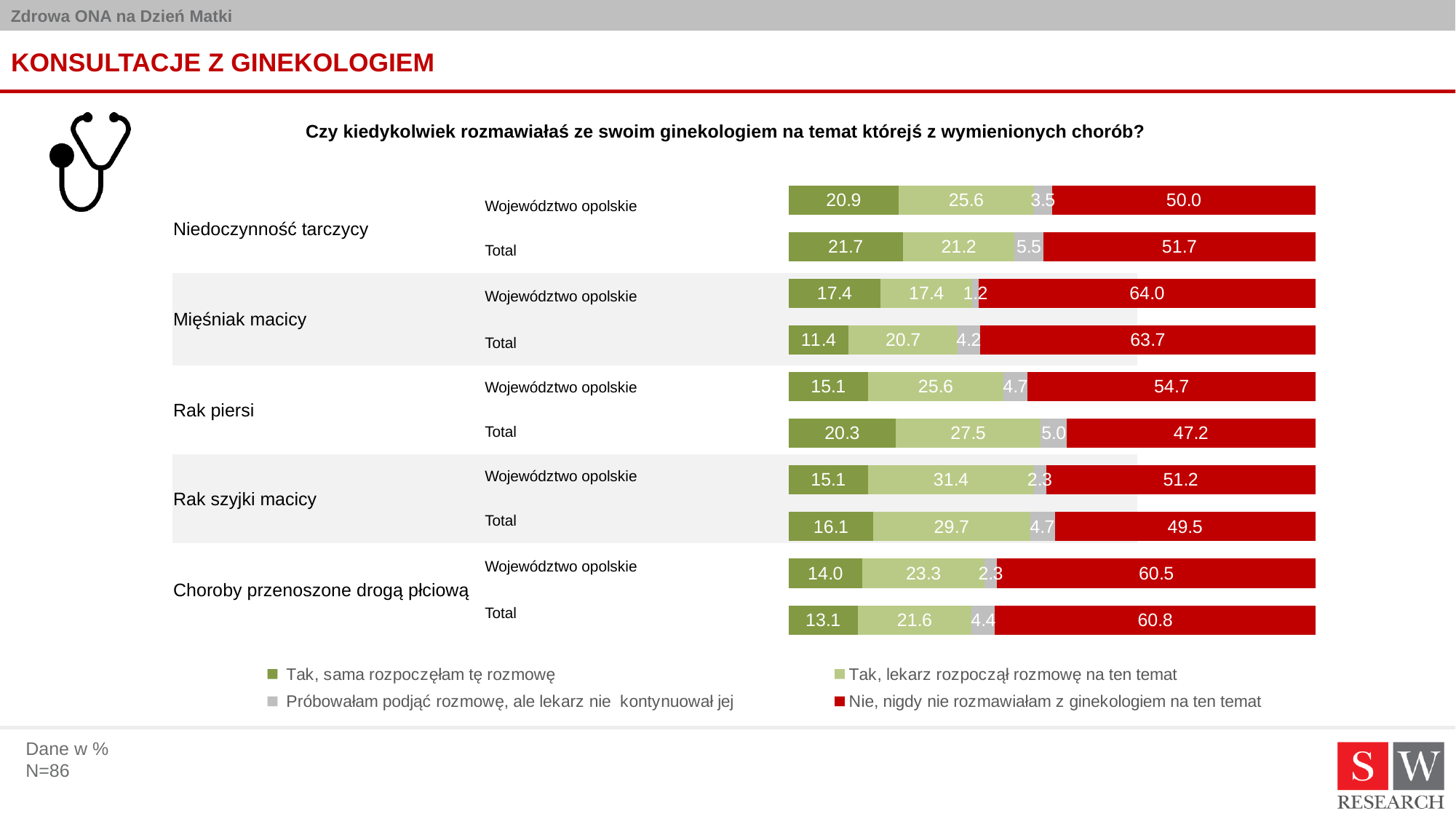
How many series does the legend list? 4 For Rak piersi, what is the difference between the Województwo opolskie and Total values for "Nie, nigdy nie rozmawiałam z ginekologiem na ten temat"? 7.5 What is the value for "Próbowałam podjąć rozmowę, ale lekarz nie kontynuował jej" for Niedoczynność tarczycy, Total? 5.5 How many bars are plotted in the chart? 10 What is the value for "Tak, sama rozpoczęłam tę rozmowę" for Rak piersi, Total? 20.3 Which colour represents "Nie, nigdy nie rozmawiałam z ginekologiem na ten temat" in the legend? Red What is the total of the stacked bar for Niedoczynność tarczycy, Województwo opolskie? 100.0 Among the Województwo opolskie bars, which disease has the highest value for "Nie, nigdy nie rozmawiałam z ginekologiem na ten temat"? Mięśniak macicy What kind of chart is shown on the slide? Stacked bar chart For Rak szyjki macicy, which has the larger value for "Tak, lekarz rozpoczął rozmowę na ten temat": Województwo opolskie or Total? Województwo opolskie What is the value for "Nie, nigdy nie rozmawiałam z ginekologiem na ten temat" for Mięśniak macicy, Województwo opolskie? 64.0 Among the Województwo opolskie bars, which disease has the lowest value for "Tak, sama rozpoczęłam tę rozmowę"? Choroby przenoszone drogą płciową